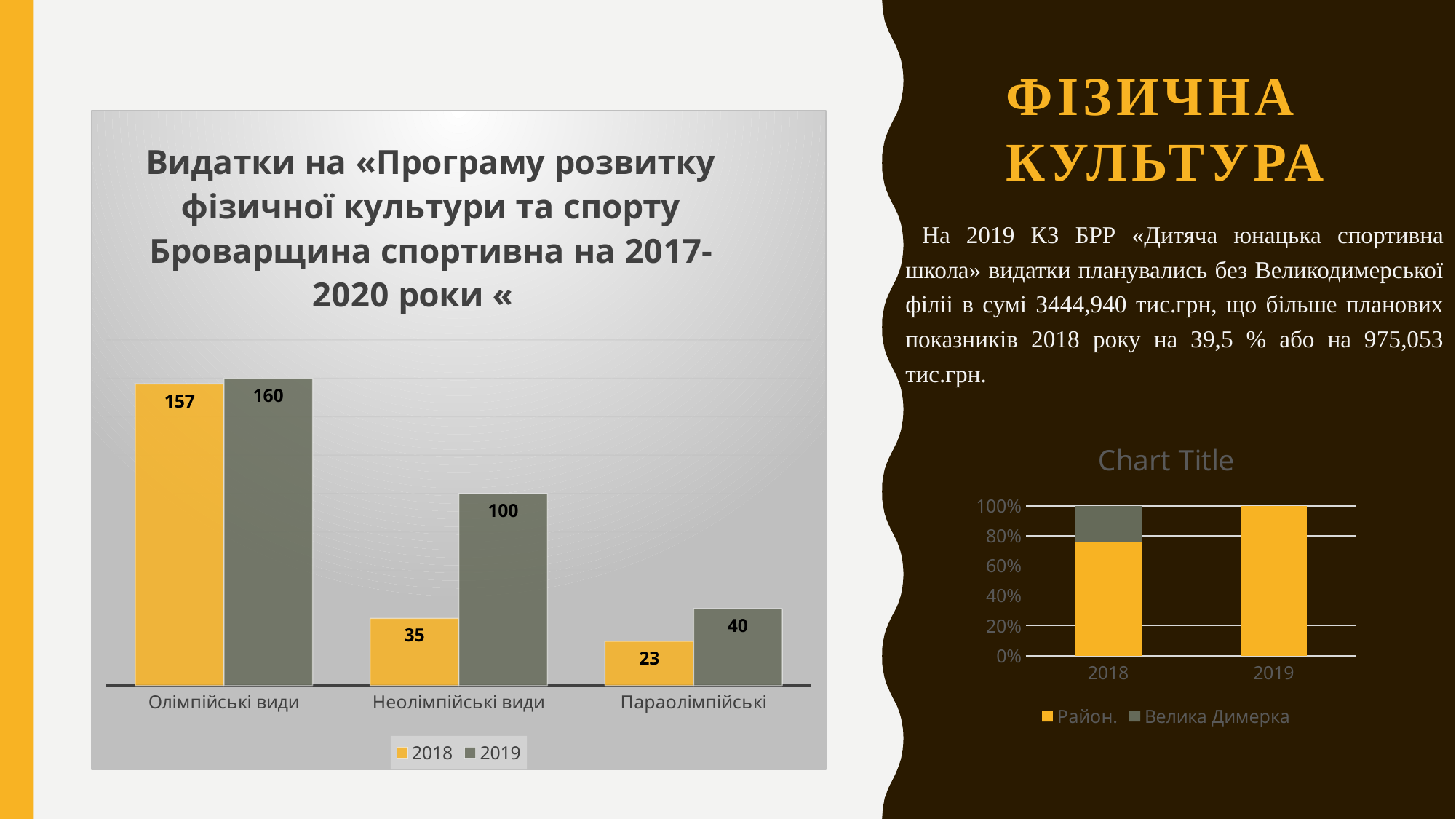
In the chart titled "Chart Title", is the Район. share for 2018 greater or less than 60%? greater Which series does the legend of the chart titled "Chart Title" list besides Район.? Велика Димерка How many categories are shown on the x axis of the left chart? 3 How many series does the legend of the left chart list? 2 In the left chart, which is larger: the 2019 value for Параолімпійські or the 2018 value for Неолімпійські види? 2019 value for Параолімпійські In the left chart, which category has the highest 2019 value? Олімпійські види In the left chart, what is the 2018 value for Параолімпійські? 23 In the left chart, what is the 2018 value for Олімпійські види? 157 In the left chart, what is the difference between the 2019 and 2018 values for Неолімпійські види? 65 In the left chart, what is the 2019 value for Неолімпійські види? 100 In the left chart, which category has the lowest 2018 value? Параолімпійські What kind of chart is the chart titled "Chart Title" on the right? Stacked bar chart